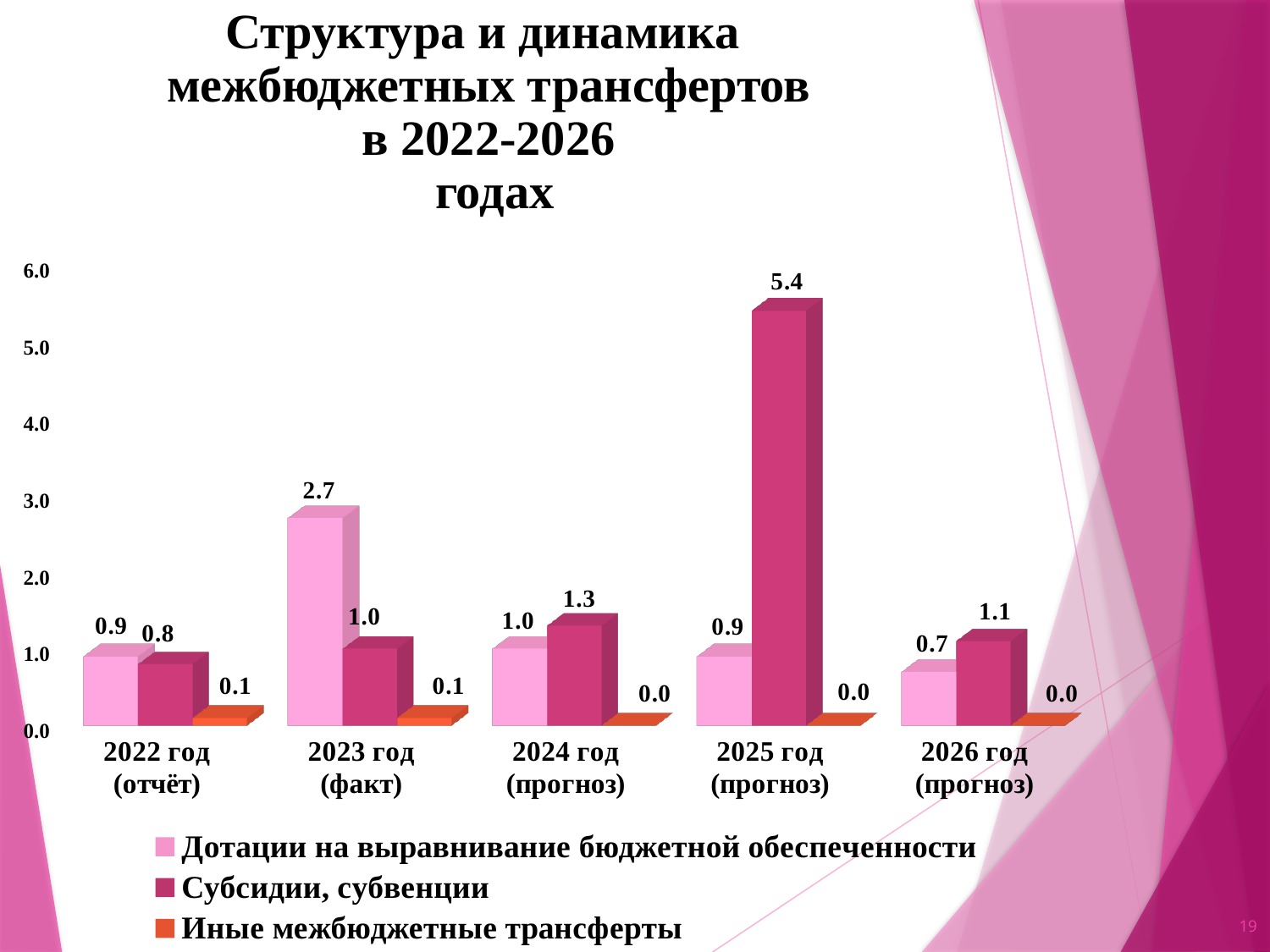
What is the value of Иные межбюджетные трансферты for 2022 год (отчёт)? 0.1 Which series is shown in orange in the legend? Иные межбюджетные трансферты What type of chart is shown on the slide? Bar chart In which year is the value of Субсидии, субвенции highest? 2025 год (прогноз) How many series does the legend list? 3 In which year is the value of Дотации на выравнивание бюджетной обеспеченности lowest? 2026 год (прогноз) What is the value of Дотации на выравнивание бюджетной обеспеченности for 2023 год (факт)? 2.7 What is the difference between Субсидии, субвенции in 2025 год (прогноз) and in 2024 год (прогноз)? 4.1 How many year categories are shown on the x axis? 5 What is the total of the three series for 2022 год (отчёт)? 1.8 Which is larger for 2024 год (прогноз): Дотации на выравнивание бюджетной обеспеченности or Субсидии, субвенции? Субсидии, субвенции What is the value of Субсидии, субвенции for 2025 год (прогноз)? 5.4